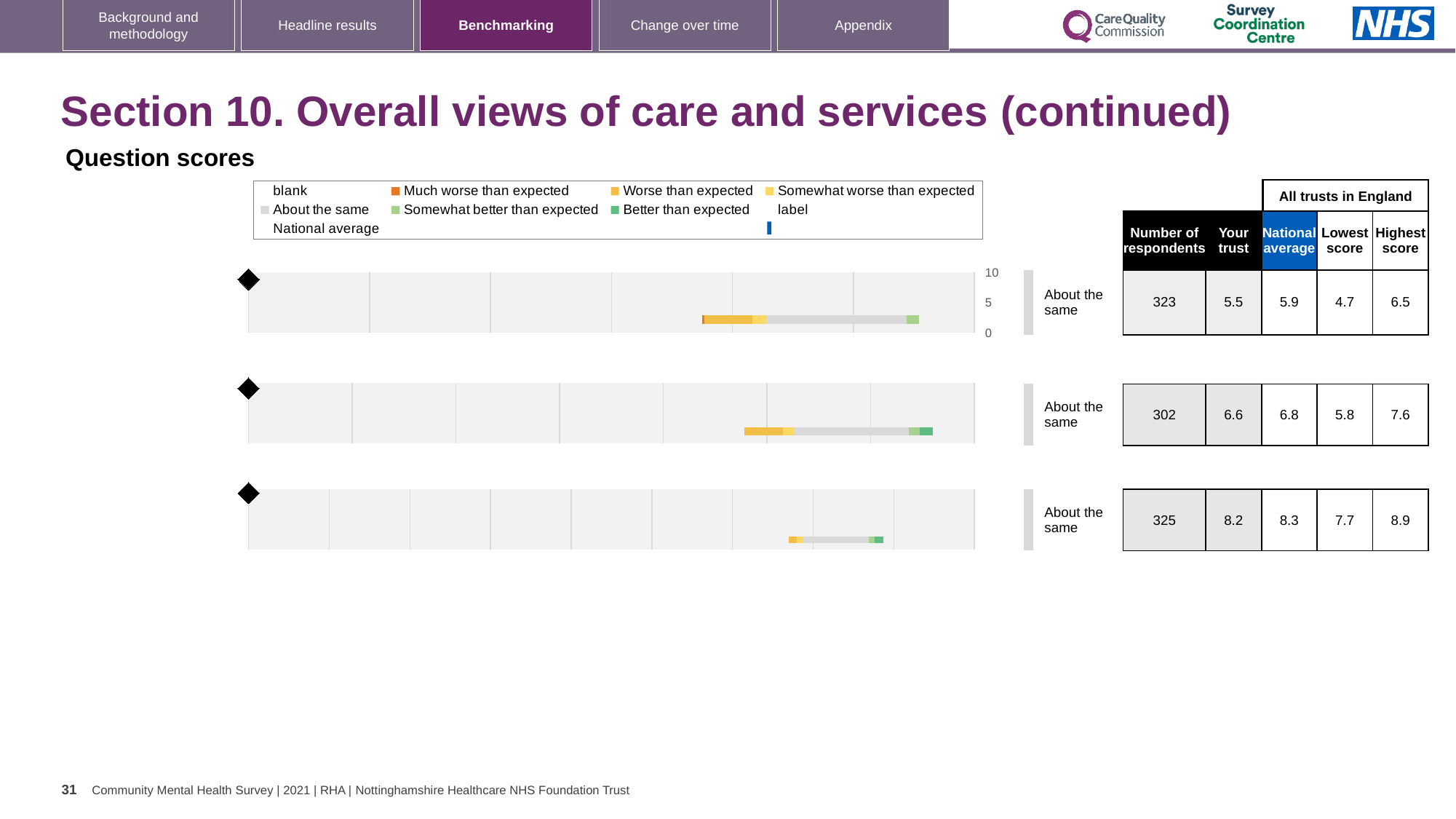
For the top chart, what is the 'Your trust' score shown in the table? 5.5 What kind of chart is used to show the question scores on this slide? bar chart For the top chart, what is the difference between the highest score and the lowest score across all trusts in England? 1.8 How many question score charts are shown on the slide? 3 For the bottom chart, how many respondents are listed? 325 In the legend, which colour represents 'Much worse than expected'? orange For the middle chart, which is larger: the 'Your trust' score or the national average? National average What benchmark category is shown next to each of the three charts? About the same For the middle chart, what is the national average score? 6.8 Which of the three charts has the lowest number of respondents? the middle chart Which of the three charts has the highest 'Your trust' score? the bottom chart Is the 'Your trust' score for the top chart greater or less than 5? greater